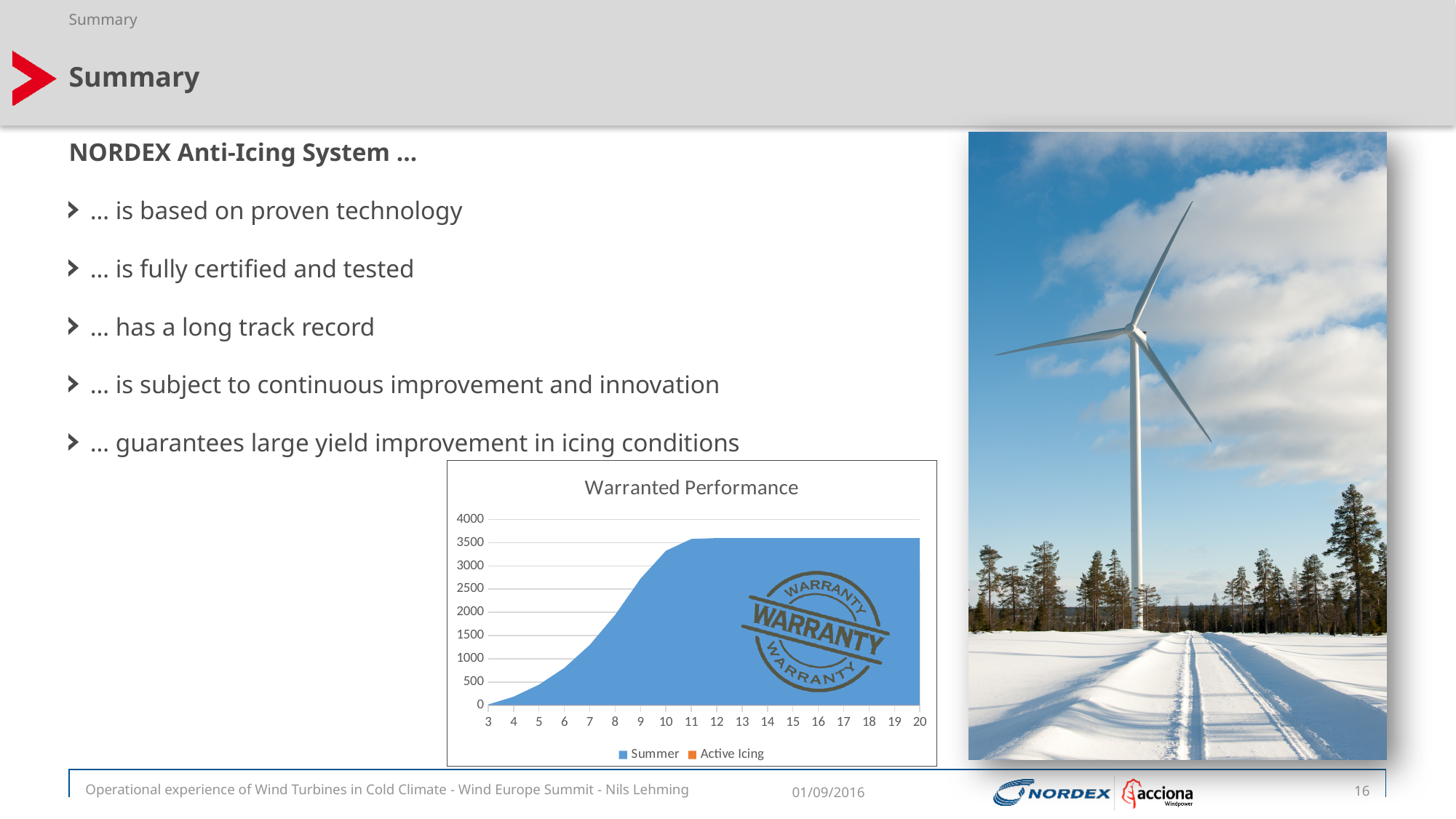
What are the two legend entries of the Warranted Performance chart? Summer and Active Icing Does the Summer series in the Warranted Performance chart rise or fall as the x-axis goes from 3 to 11? rise At which x-axis value is the Summer series lowest in the Warranted Performance chart? 3 In the Warranted Performance chart, which is larger: the Summer value at x = 5 or at x = 10? x = 10 What is the title of the chart on the slide? Warranted Performance In the Warranted Performance chart, is the Summer value at x = 4 greater or less than 500? less In the Warranted Performance chart, is the Summer value at x = 10 greater or less than 3000? greater How many series does the legend of the Warranted Performance chart list? 2 In the Warranted Performance chart, is the Summer value at x = 15 greater or less than 4000? less What kind of chart is shown under the heading "Warranted Performance"? area chart How many x-axis categories are shown on the Warranted Performance chart? 18